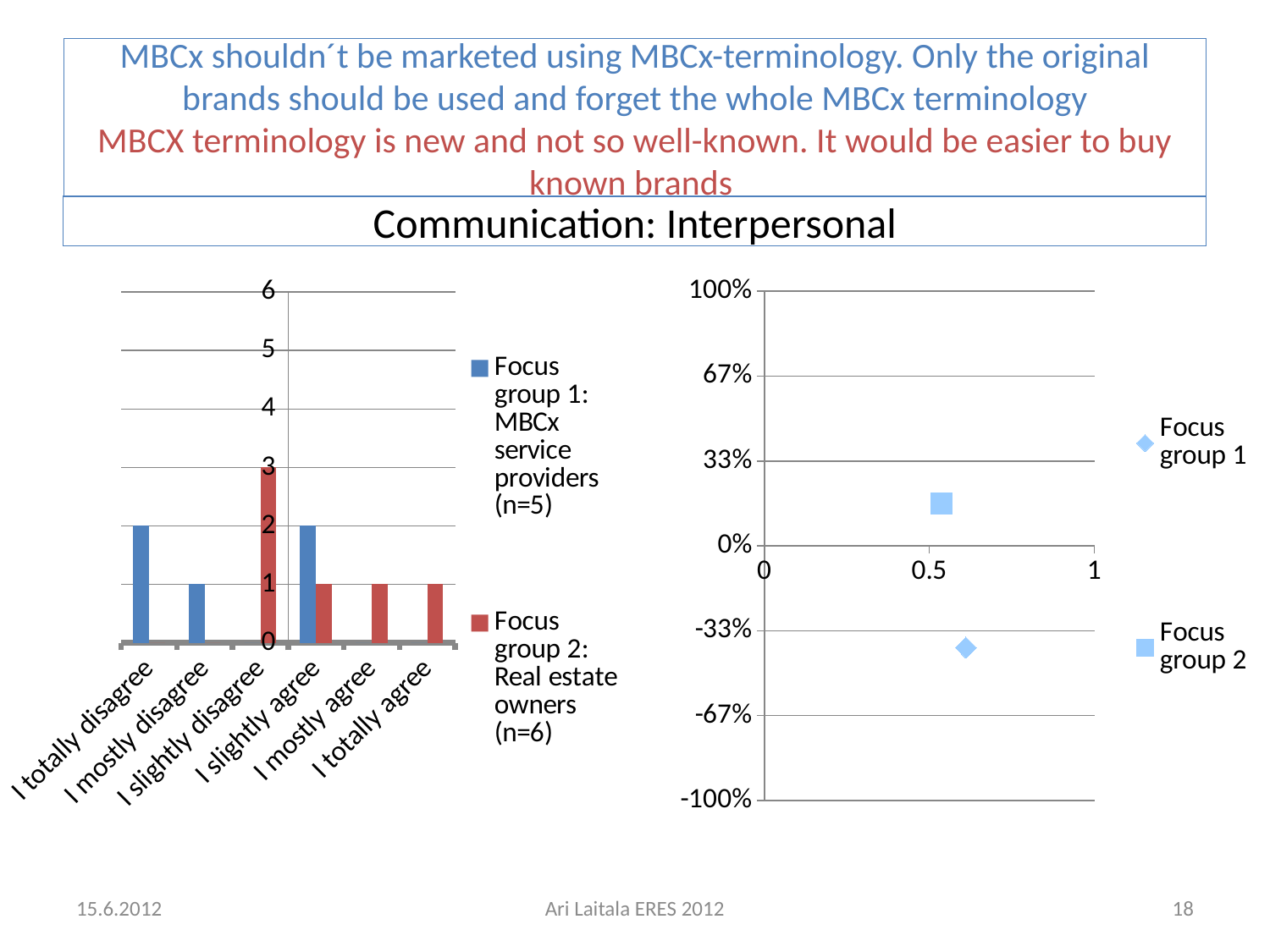
On the left bar chart, what is the difference between Focus group 1 and Focus group 2 at 'I slightly agree'? 1 On the right scatter chart, which series has the higher vertical value: Focus group 1 or Focus group 2? Focus group 2 On the right scatter chart, is the vertical value for Focus group 1 greater or less than 0%? less On the left bar chart, what is the value for Focus group 1 at 'I mostly disagree'? 1 On the left bar chart, which is larger at 'I slightly agree': Focus group 1 or Focus group 2? Focus group 1 On the left bar chart, how many categories are shown on the x axis? 6 On the left bar chart, which category has the highest value for Focus group 2? I slightly disagree On the left bar chart, what is the value for Focus group 2 at 'I slightly disagree'? 3 On the left bar chart, what kind of chart is it? bar chart On the left bar chart, what is the value for Focus group 1 at 'I totally disagree'? 2 On the left bar chart, how many series does the legend list? 2 On the right scatter chart, is the vertical value for Focus group 2 greater or less than 0%? greater